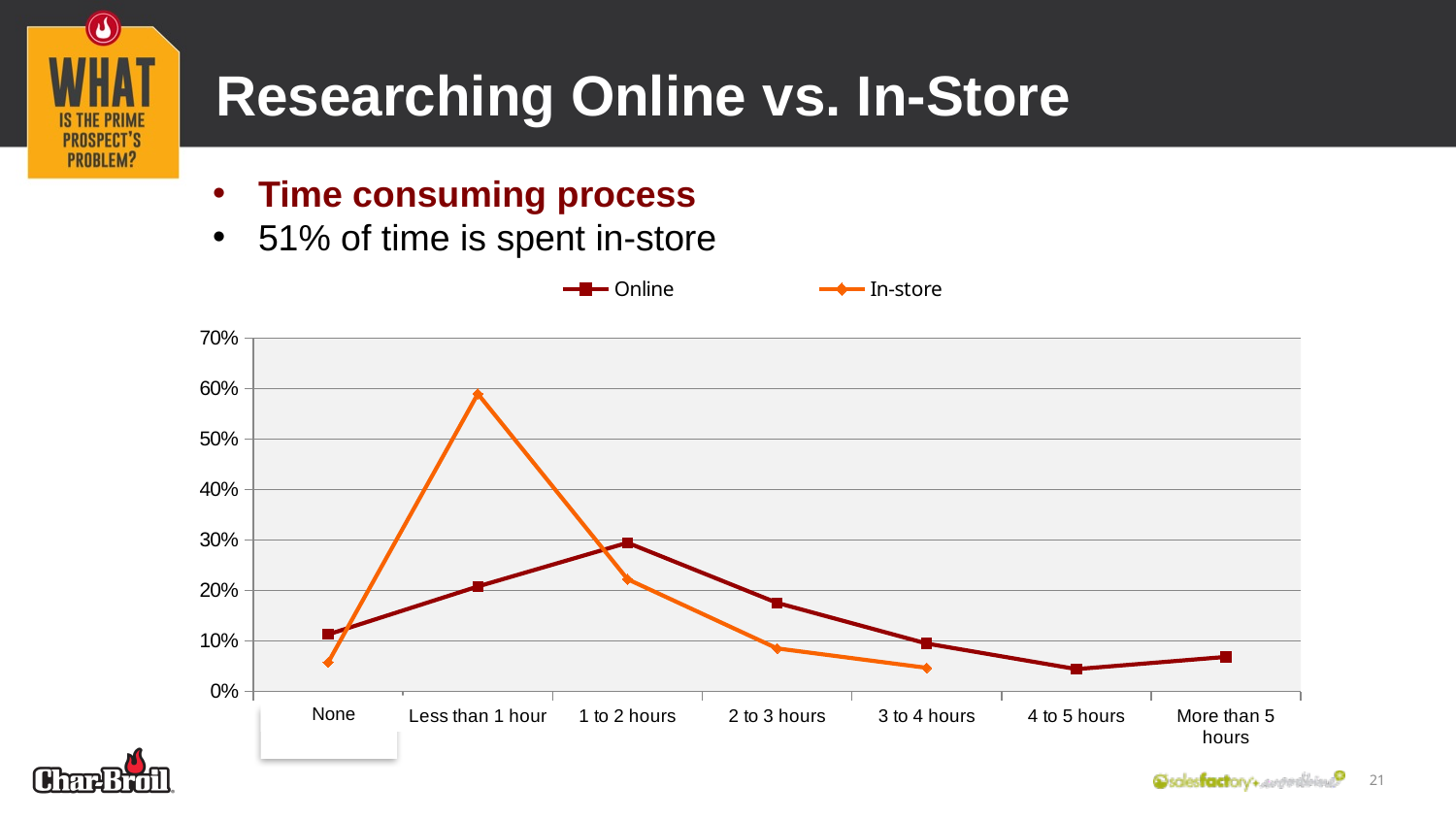
Is the In-store value for None greater or less than 10%? less Is the Online value for 1 to 2 hours greater or less than 20%? greater Is the In-store value for Less than 1 hour greater or less than 50%? greater Which series has the larger value for Less than 1 hour, Online or In-store? In-store Does the Online series rise or fall from 1 to 2 hours to 4 to 5 hours? Fall For which category is the Online series lowest? 4 to 5 hours For which category is the In-store series highest? Less than 1 hour For which category is the Online series highest? 1 to 2 hours Which series has the larger value for 2 to 3 hours, Online or In-store? Online How many categories are shown on the x axis? 7 What kind of chart is shown on the slide? Line chart How many series does the legend list? 2